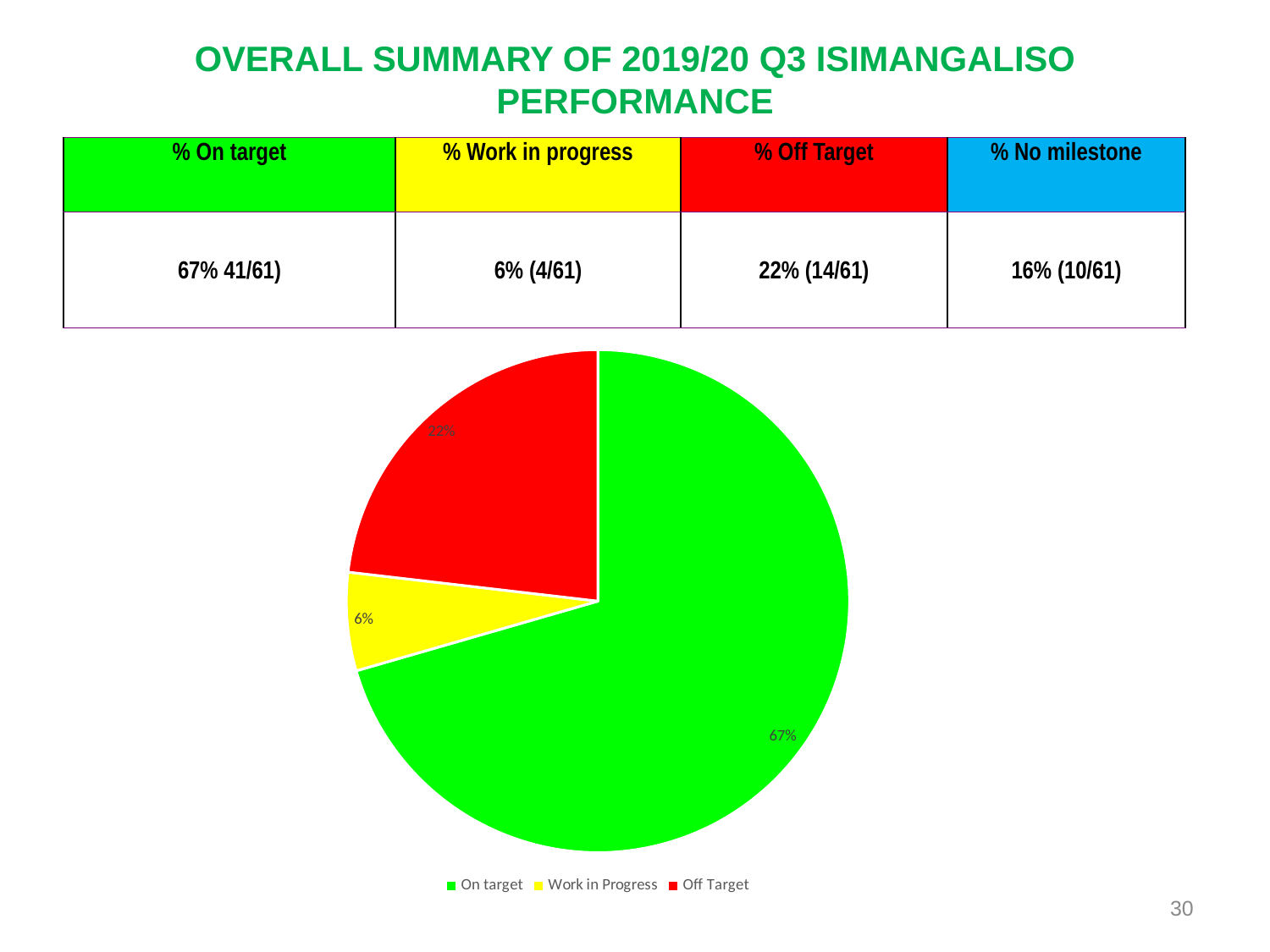
What colour is the Off Target slice in the pie chart? red How many slices does the pie chart have? 3 Which slice of the pie chart is the largest? On target Which slice of the pie chart is the smallest? Work in Progress What is the difference in percentage points between the Off Target slice and the Work in Progress slice? 16 What percentage of the pie is labelled for On target? 67% Which is larger in the pie chart, Off Target or Work in Progress? Off Target What type of chart is shown on the slide? pie chart What is the difference in percentage points between the On target slice and the Off Target slice? 45 How many entries does the legend of the pie chart list? 3 What percentage of the pie is labelled for Work in Progress? 6% What percentage of the pie is labelled for Off Target? 22%